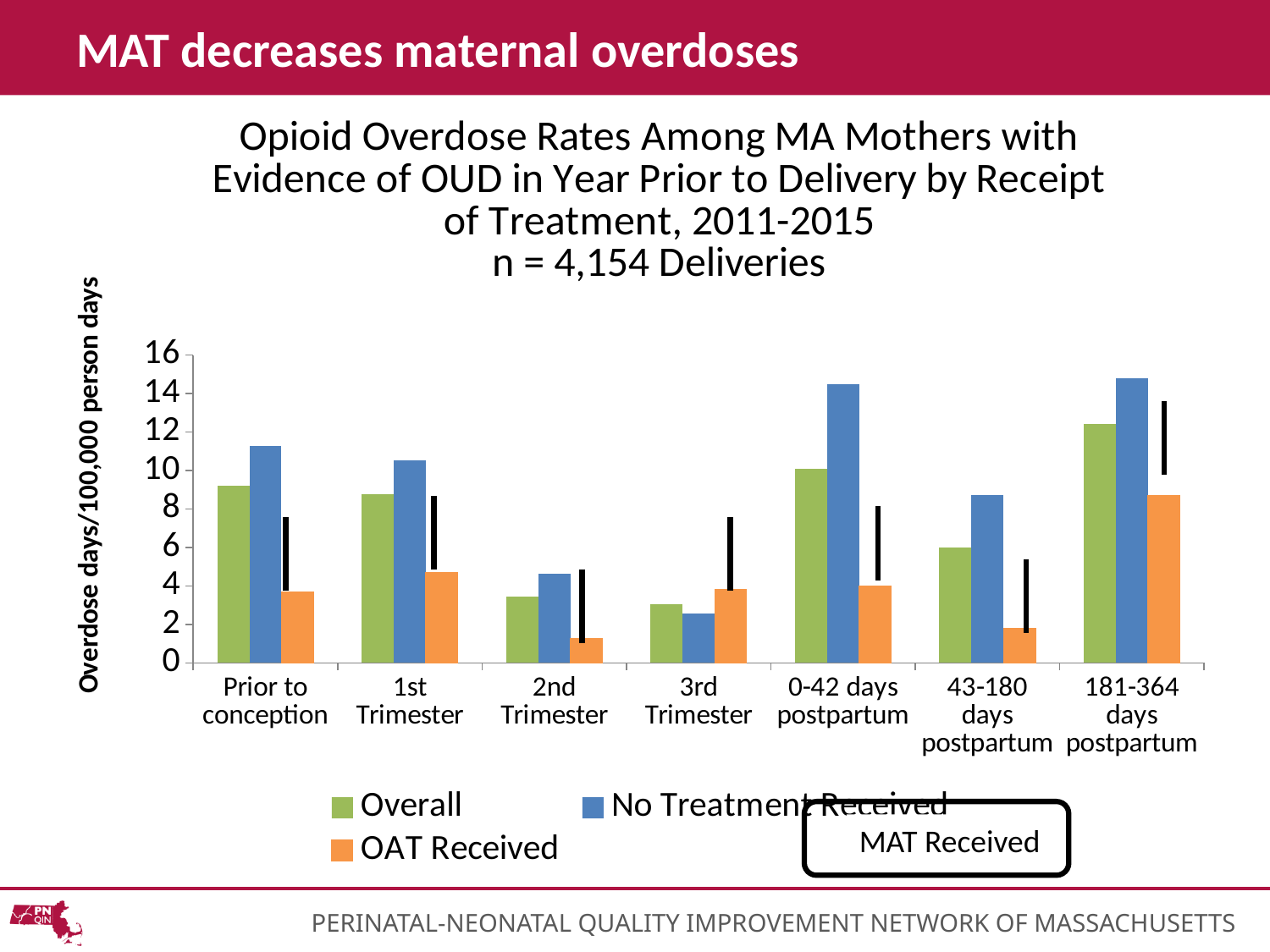
How many series does the legend list? 3 How many time-period categories are shown on the x axis? 7 In the 3rd Trimester category, which is larger: the OAT Received value or the No Treatment Received value? OAT Received Is the No Treatment Received value for 0-42 days postpartum greater or less than 12? greater Which category has the highest value for the Overall series? 181-364 days postpartum What kind of chart is shown on the slide? Bar chart For Prior to conception, which is larger: the Overall value or the No Treatment Received value? No Treatment Received Is the OAT Received value for Prior to conception greater or less than 6? less Is the Overall value for 181-364 days postpartum greater or less than 10? greater Which category has the highest value for the OAT Received series? 181-364 days postpartum What is the label on the y axis of the chart? Overdose days/100,000 person days